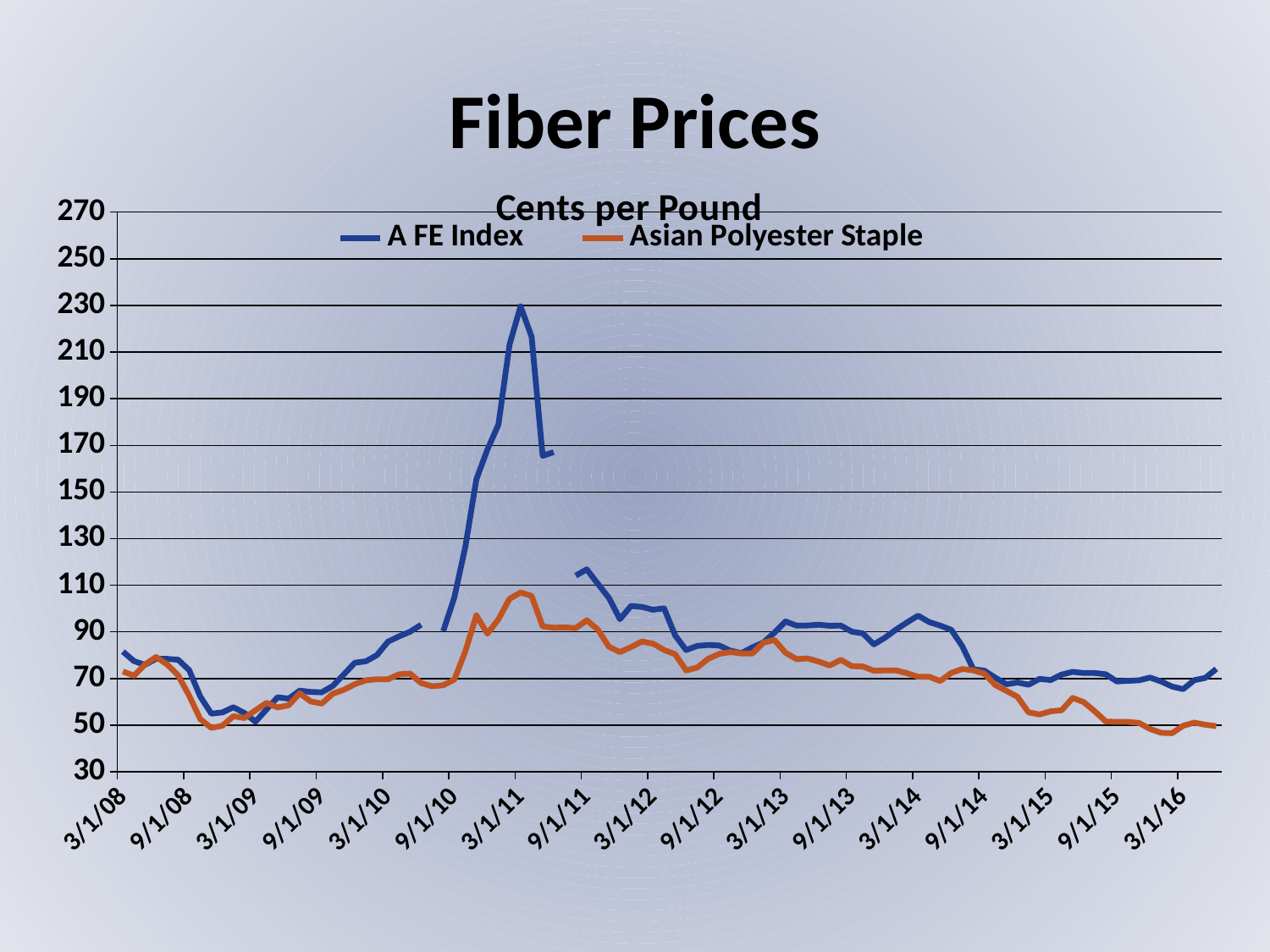
Is the peak value of the A FE Index around 3/1/11 greater or less than 210? greater Does the Asian Polyester Staple series rise or fall between 3/1/14 and 3/1/16? fall What unit is given in the chart subtitle? Cents per Pound Which series reaches the highest value on the chart? A FE Index At 3/1/11, which series has the higher value, A FE Index or Asian Polyester Staple? A FE Index Is the value of Asian Polyester Staple at 3/1/16 greater or less than 70? less Does the A FE Index rise or fall between 9/1/10 and 3/1/11? rise How many series does the legend list? 2 Is the value of the A FE Index at 3/1/13 greater or less than 110? less At 3/1/15, which series has the higher value, A FE Index or Asian Polyester Staple? A FE Index What kind of chart is shown on the slide? line chart What is the title of the chart? Cents per Pound